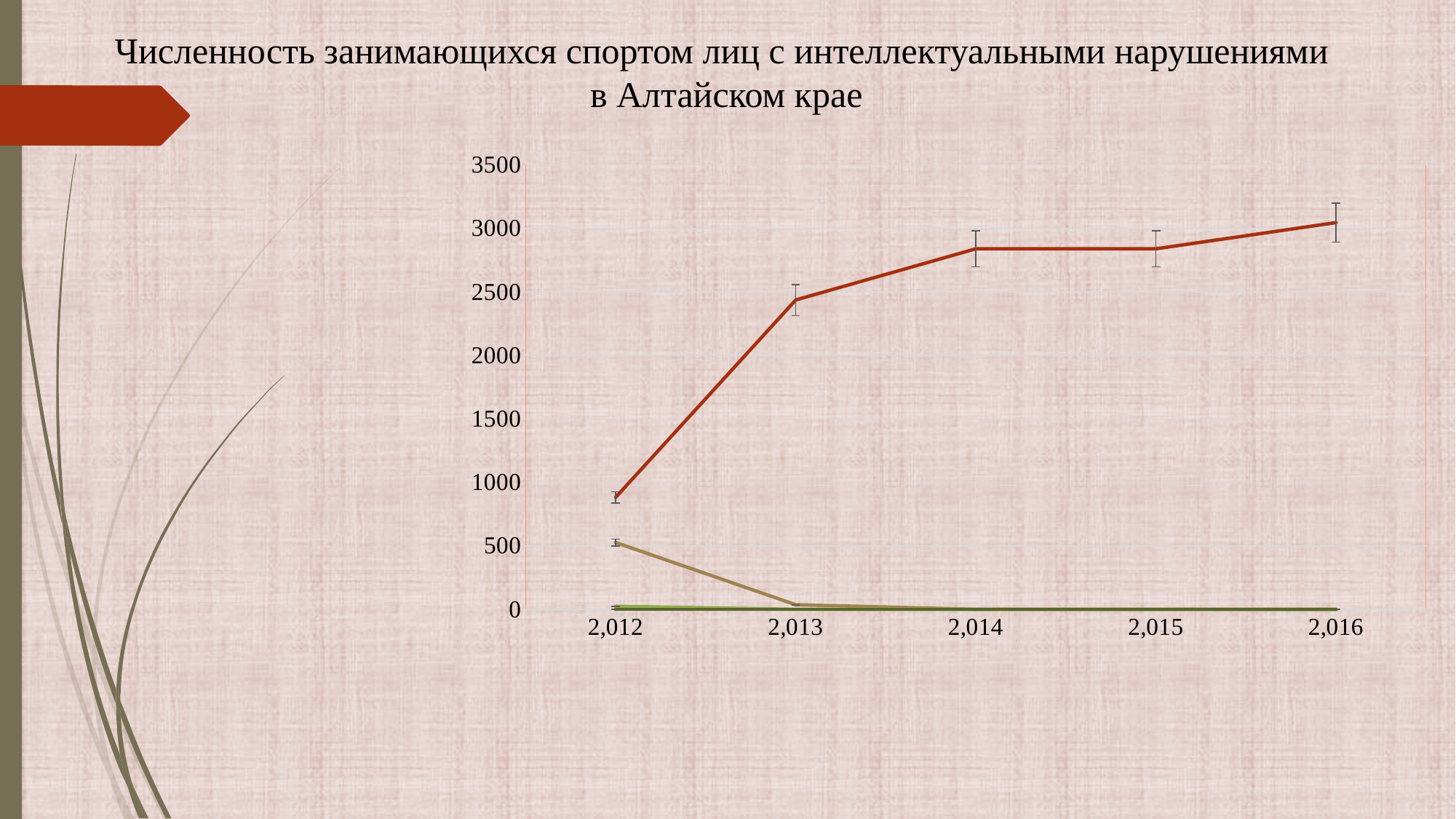
How many years are shown along the x axis of the chart? 5 Is the value of the red line for 2,013 larger or smaller than its value for 2,014? smaller Does the red line rise or fall from 2,012 to 2,016? rise In which year does the red line reach its highest value? 2,016 Is the value of the red line for 2,014 greater or less than 2500? greater What is the title of the chart on the slide? Численность занимающихся спортом лиц с интеллектуальными нарушениями в Алтайском крае Does the tan (brown) line rise or fall from 2,012 to 2,013? fall In which year does the red line have its lowest value? 2,012 What kind of chart is shown on the slide? line chart Is the value of the red line for 2,012 greater or less than 1000? less Is the value of the red line for 2,013 greater or less than 2000? greater